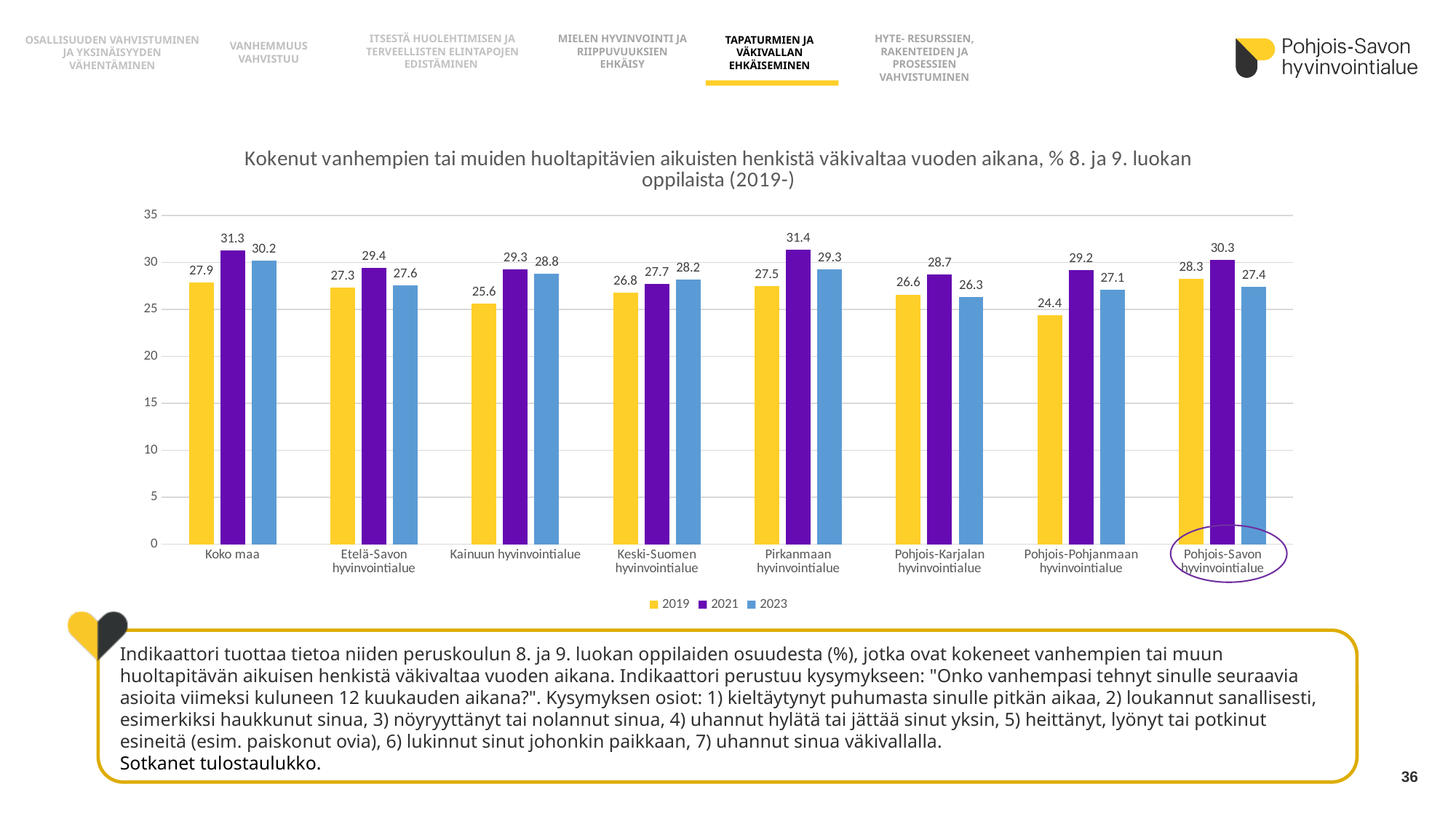
What kind of chart is shown on the slide? Bar chart Do the values for Pohjois-Savon hyvinvointialue rise or fall from 2021 to 2023? Fall What is the 2021 value for Pohjois-Savon hyvinvointialue? 30.3 How many series does the legend list? 3 What is the difference between the 2021 and 2023 values for Pohjois-Savon hyvinvointialue? 2.9 What is the 2019 value for Koko maa? 27.9 Which category has the highest 2021 value? Pirkanmaan hyvinvointialue How many categories are shown on the x axis? 8 Which series is shown in yellow in the legend? 2019 Which category has the lowest 2019 value? Pohjois-Pohjanmaan hyvinvointialue What is the 2023 value for Kainuun hyvinvointialue? 28.8 Which is larger for Keski-Suomen hyvinvointialue: the 2019 value or the 2023 value? 2023